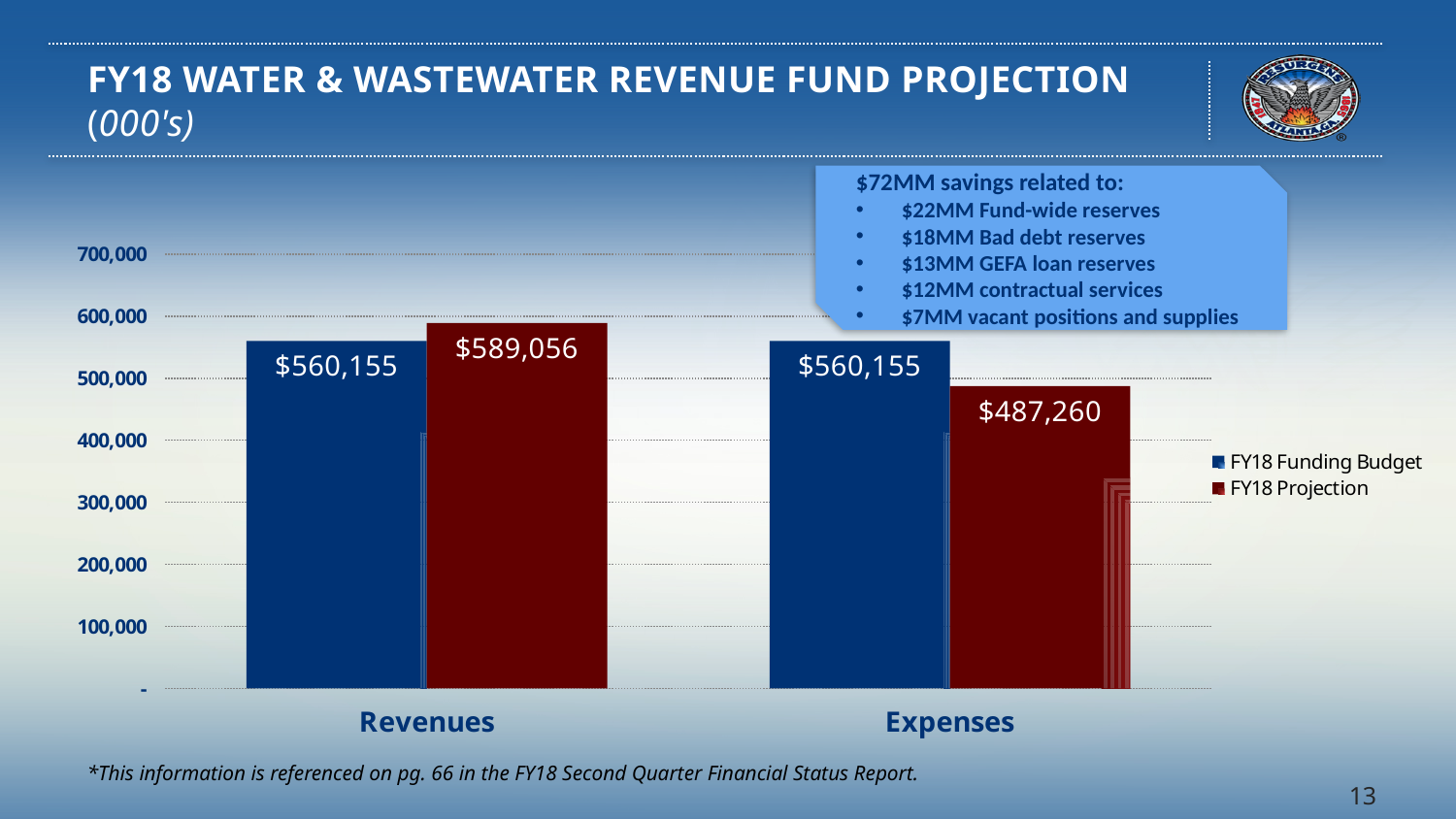
What is the difference between the FY18 Funding Budget and the FY18 Projection for Expenses? $72,895 How many categories are shown on the x axis of the chart? 2 For Expenses, which is larger: the FY18 Funding Budget or the FY18 Projection? FY18 Funding Budget What is the FY18 Projection value for Expenses? $487,260 What is the FY18 Projection value for Revenues? $589,056 Which bar on the chart has the lowest value? FY18 Projection for Expenses What is the FY18 Funding Budget value for Expenses? $560,155 Which bar on the chart has the highest value? FY18 Projection for Revenues How many series does the chart legend list? 2 What is the difference between the FY18 Projection and the FY18 Funding Budget for Revenues? $28,901 What type of chart is shown on the slide? Bar chart What is the FY18 Funding Budget value for Revenues? $560,155